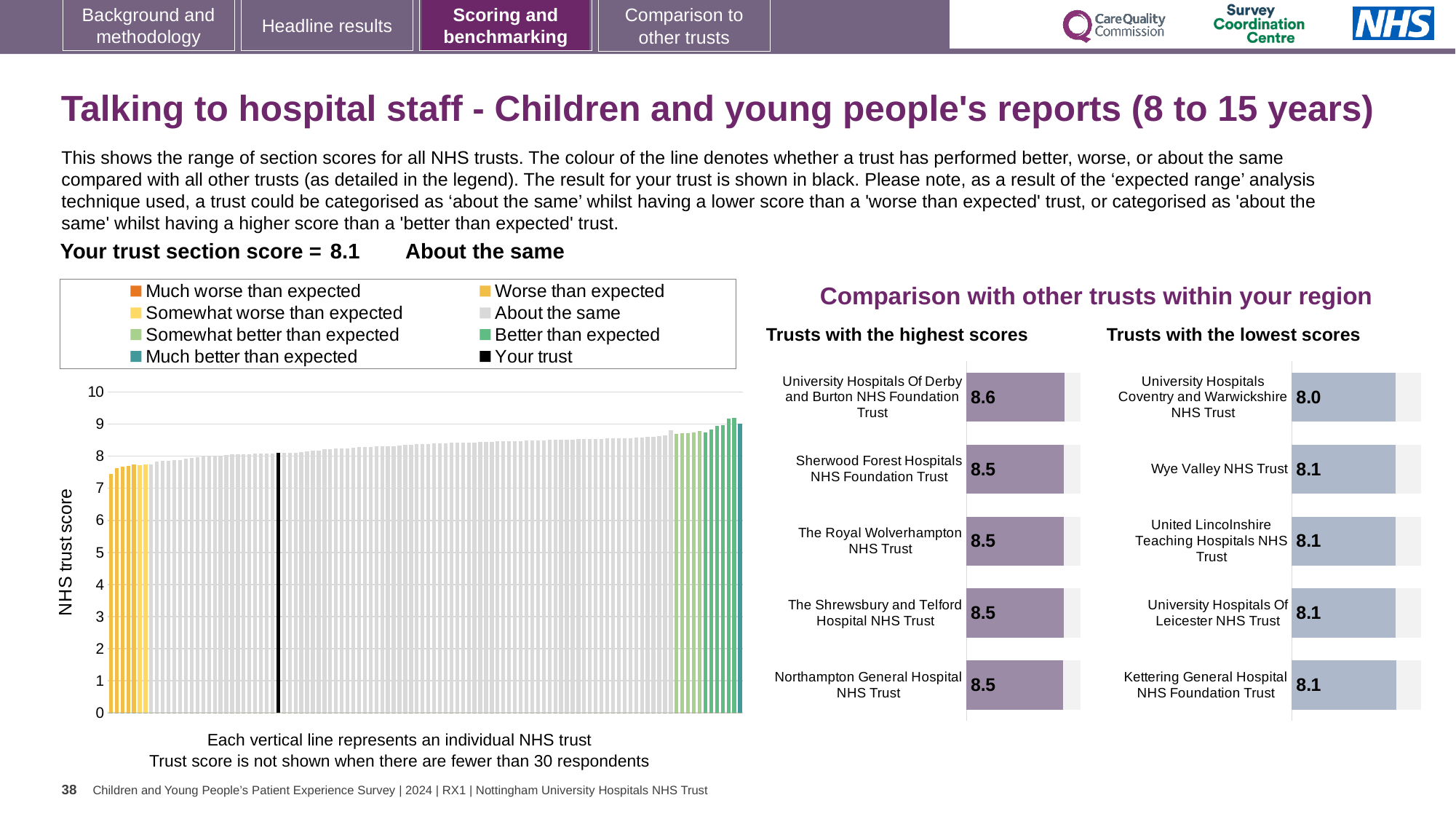
In the 'Trusts with the highest scores' chart, what is the score for Northampton General Hospital NHS Trust? 8.5 In the 'Trusts with the lowest scores' chart, what is the score for Wye Valley NHS Trust? 8.1 In the 'Trusts with the highest scores' chart, what is the score for University Hospitals Of Derby and Burton NHS Foundation Trust? 8.6 How many trusts are shown in the 'Trusts with the lowest scores' chart? 5 How many entries does the legend of the large 'NHS trust score' chart on the left list? 8 In the 'Trusts with the highest scores' chart, what is the difference between the scores of University Hospitals Of Derby and Burton NHS Foundation Trust and Sherwood Forest Hospitals NHS Foundation Trust? 0.1 In the large 'NHS trust score' chart on the left, do the bar values rise or fall from left to right? rise Which is larger: the score for University Hospitals Of Derby and Burton NHS Foundation Trust in the highest scores chart, or the score for University Hospitals Coventry and Warwickshire NHS Trust in the lowest scores chart? University Hospitals Of Derby and Burton NHS Foundation Trust In the 'Trusts with the lowest scores' chart, which trust has the lowest score? University Hospitals Coventry and Warwickshire NHS Trust In the 'Trusts with the highest scores' chart, which trust has the highest score? University Hospitals Of Derby and Burton NHS Foundation Trust In the 'Trusts with the lowest scores' chart, what is the score for University Hospitals Coventry and Warwickshire NHS Trust? 8.0 In the large 'NHS trust score' chart on the left, is the value of the leftmost (lowest) bar greater or less than 8? less